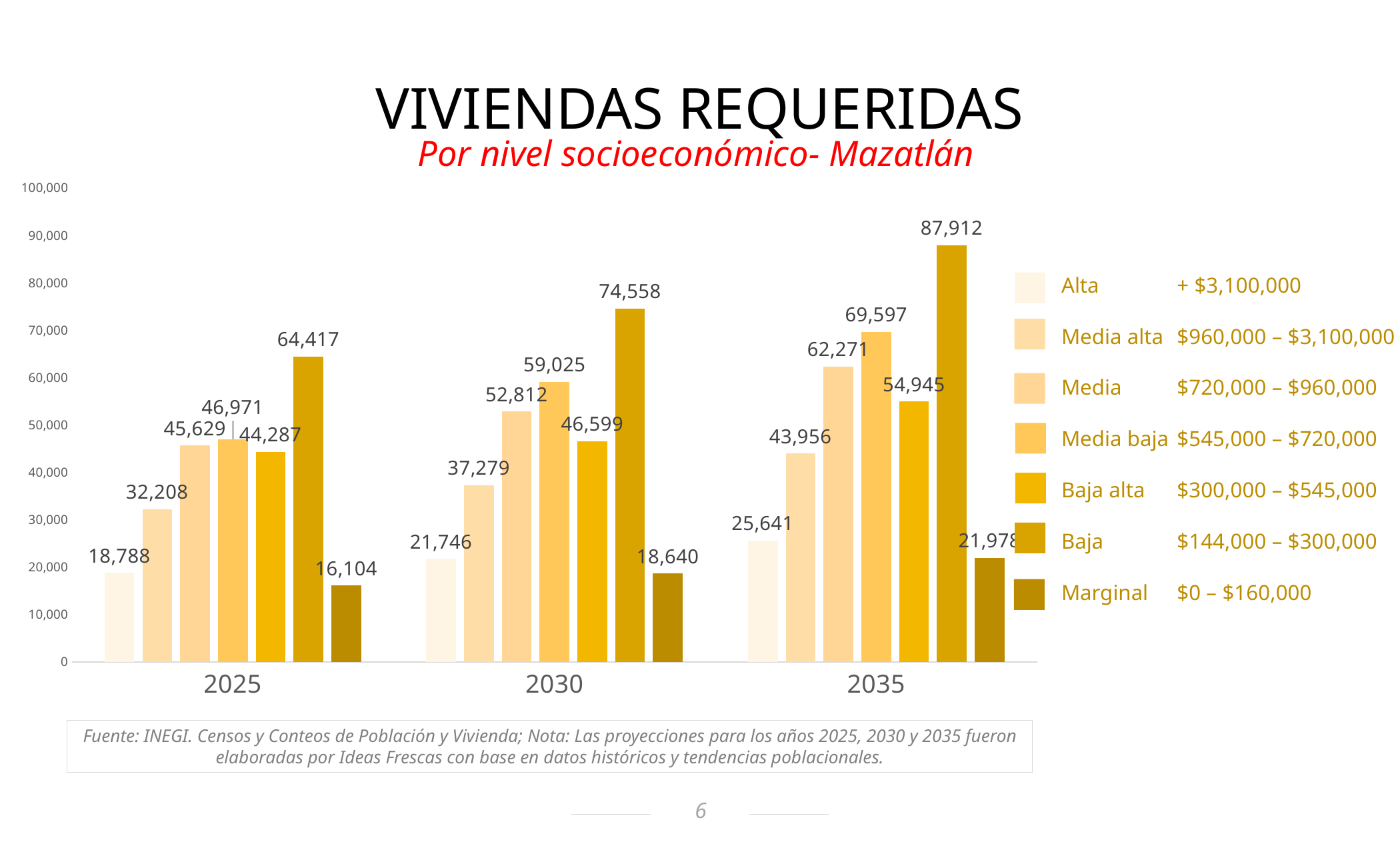
What is the difference between the Baja values for 2035 and 2025? 23,495 What is the value for Alta in 2025? 18,788 What kind of chart is shown on the slide? Bar chart Which socioeconomic level has the lowest value in 2025? Marginal How many year categories are shown on the x axis? 3 What is the value for Marginal in 2030? 18,640 Which socioeconomic level has the highest value in 2030? Baja Which is larger in 2025: Media or Baja alta? Media What is the value for Baja in 2035? 87,912 What is the value for Media baja in 2030? 59,025 Do the Media alta values rise or fall from 2025 to 2035? Rise How many series does the legend list? 7